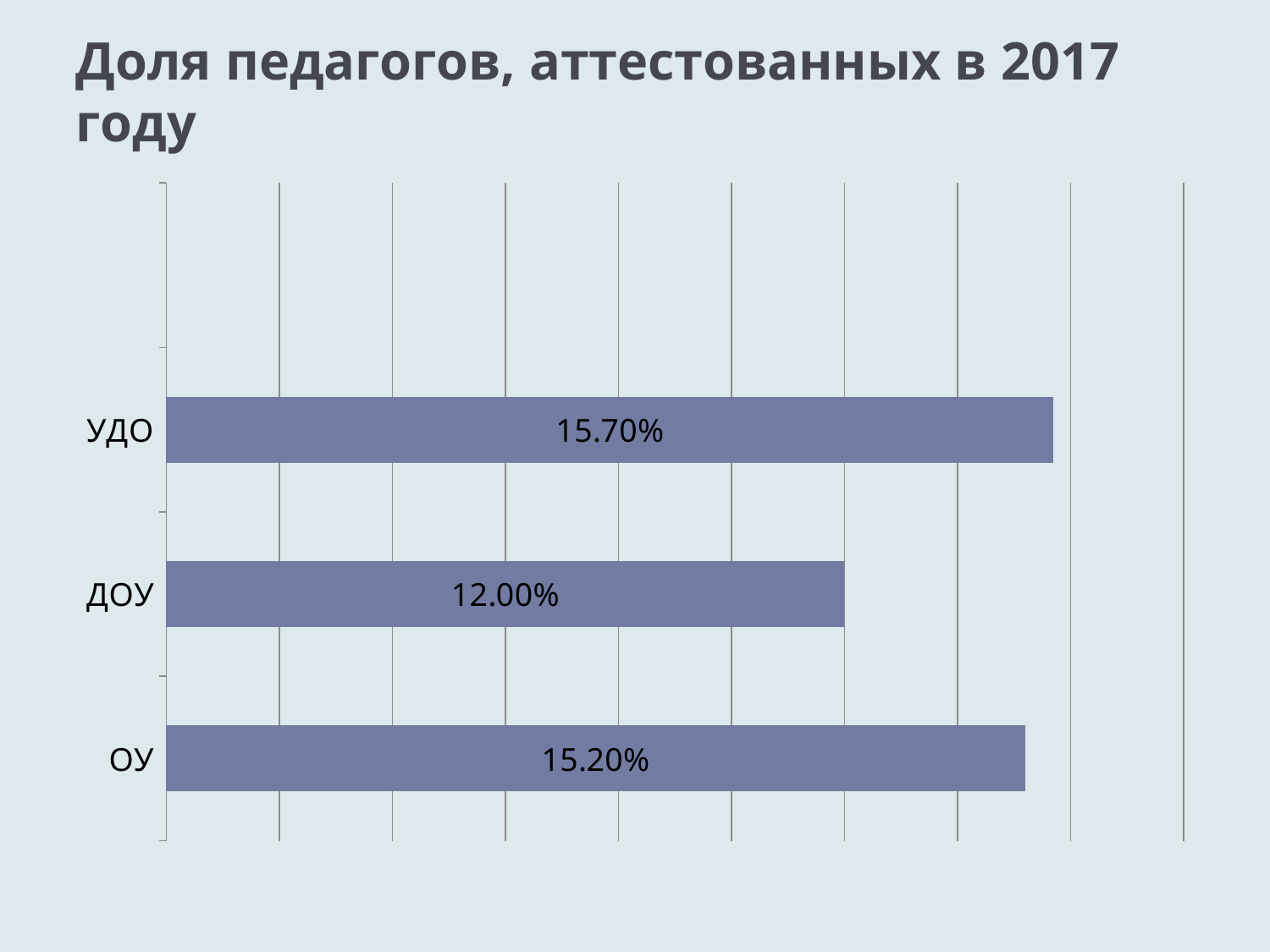
What kind of chart is shown on the slide? Bar chart Which category has the lowest value? ДОУ What is the title of the chart? Доля педагогов, аттестованных в 2017 году Which is larger, the value for ОУ or the value for ДОУ? ОУ What is the difference between the values for УДО and ДОУ? 3.70% What is the value for ДОУ? 12.00% What is the value for ОУ? 15.20% Which category has the highest value? УДО How many categories are shown in the chart? 3 What is the difference between the values for ОУ and ДОУ? 3.20% Which category is listed at the top of the chart? УДО What is the value for УДО? 15.70%